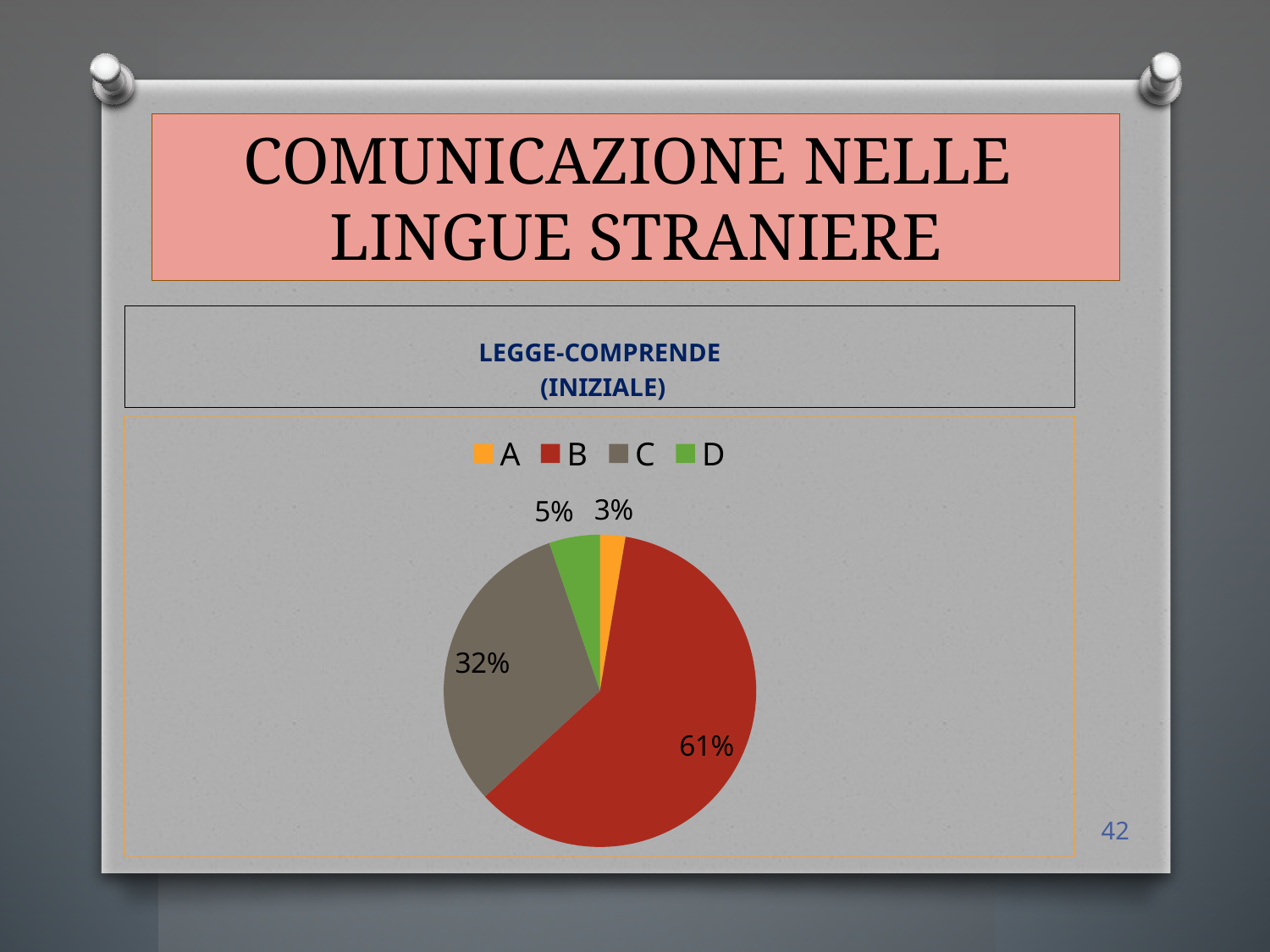
Which category has the largest slice of the pie? B What percentage of the pie does category B represent? 61% What is the difference in percentage points between category B and category C? 29 What percentage of the pie does category D represent? 5% What is the title shown above the pie chart? LEGGE-COMPRENDE (INIZIALE) What kind of chart is shown on the slide? pie chart What percentage of the pie does category C represent? 32% Which category has the smallest slice of the pie? A How many categories does the legend list? 4 What colour is the slice for category B? red What percentage of the pie does category A represent? 3% Which is larger, the slice for category C or the slice for category D? C